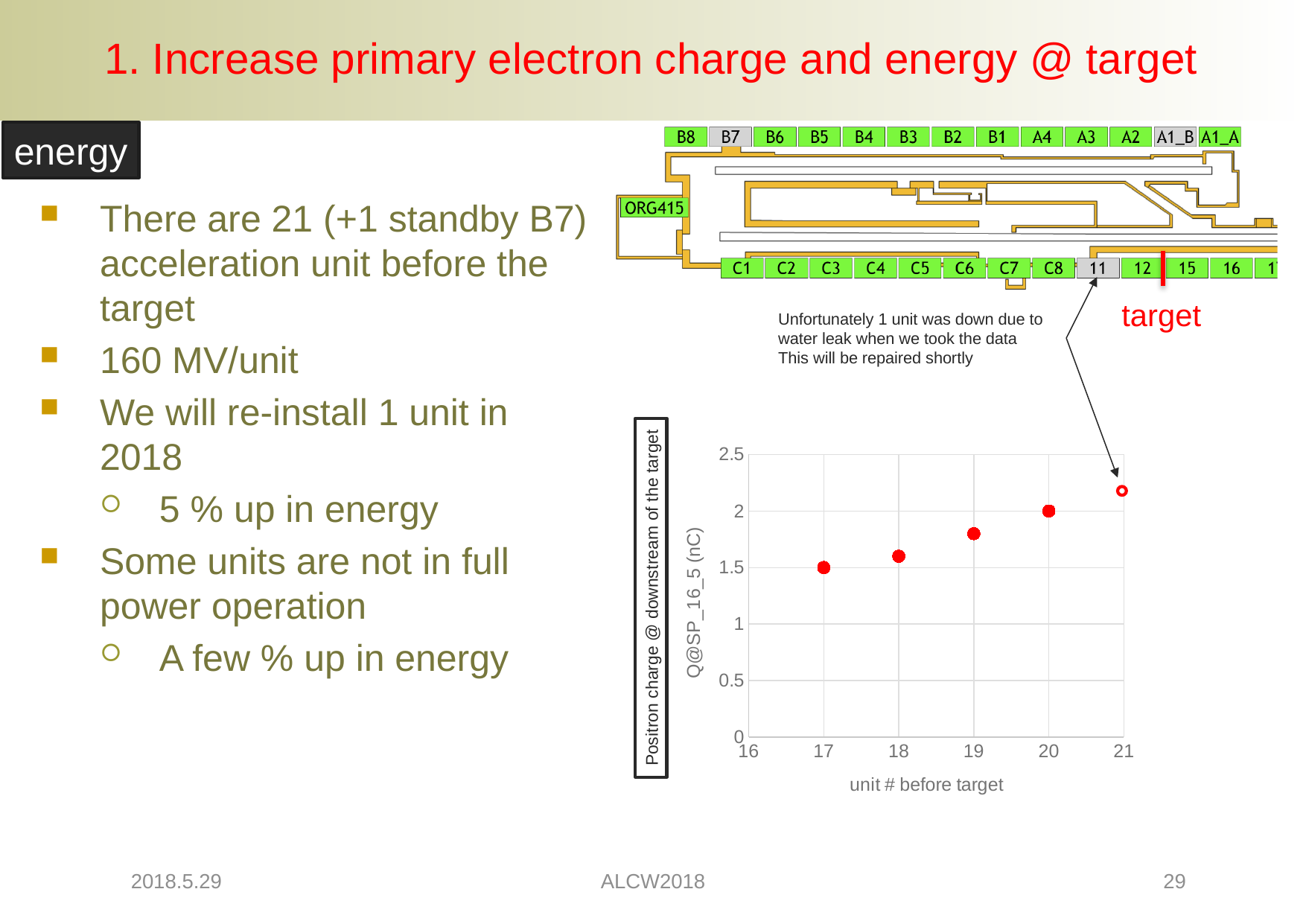
Which has a larger positron charge, unit # 18 or unit # 20? 20 What is the y-axis title of the chart? Q@SP_16_5 (nC) Is the value for unit # 17 greater or less than 2? less Is the value for unit # 19 greater or less than 2? less Is the value for unit # 21 greater or less than 2? greater What kind of chart is shown on the slide? scatter plot How many data points are plotted in the chart? 5 Do the plotted values rise or fall as the unit # before target increases? rise Which unit # before target has the lowest positron charge? 17 What is the x-axis title of the chart? unit # before target Which unit # before target has the highest positron charge? 21